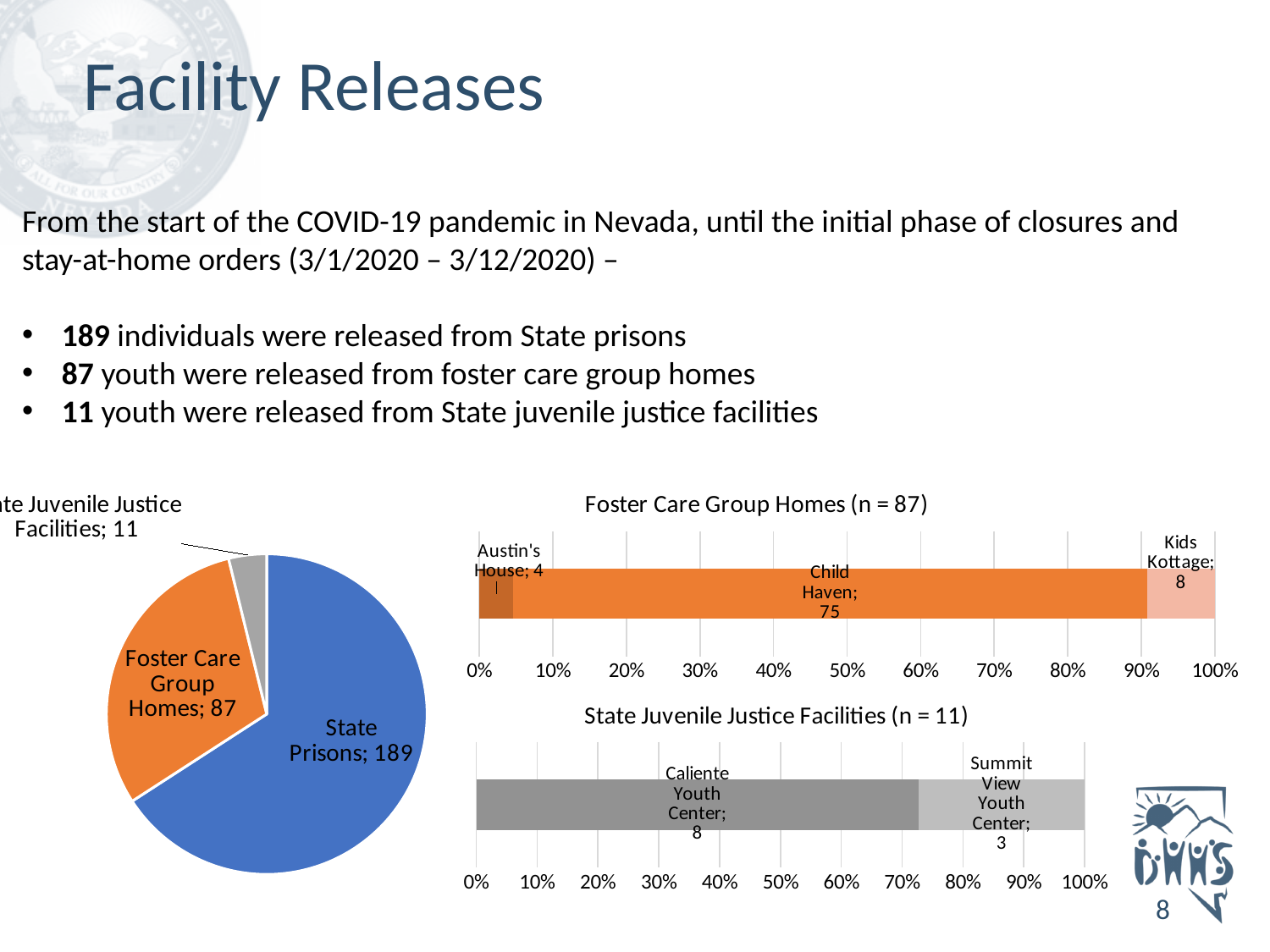
In the pie chart on the left, how many individuals were released from State Prisons? 189 In the 'State Juvenile Justice Facilities (n = 11)' chart, which is larger, Caliente Youth Center or Summit View Youth Center? Caliente Youth Center In the pie chart on the left, how many slices are there? 3 In the 'Foster Care Group Homes (n = 87)' chart, what is the total of the stacked bar? 87 In the 'Foster Care Group Homes (n = 87)' chart, is the Child Haven segment greater or less than 80% of the bar? greater In the pie chart on the left, what is the difference between the State Prisons value and the Foster Care Group Homes value? 102 What kind of chart is the 'State Juvenile Justice Facilities (n = 11)' chart? Stacked bar chart In the 'Foster Care Group Homes (n = 87)' chart, which facility has the lowest value? Austin's House In the pie chart on the left, which category has the smallest slice? State Juvenile Justice Facilities In the 'State Juvenile Justice Facilities (n = 11)' chart, what is the value for Summit View Youth Center? 3 In the 'Foster Care Group Homes (n = 87)' chart, what is the value for Child Haven? 75 In the pie chart on the left, which category has the largest slice? State Prisons